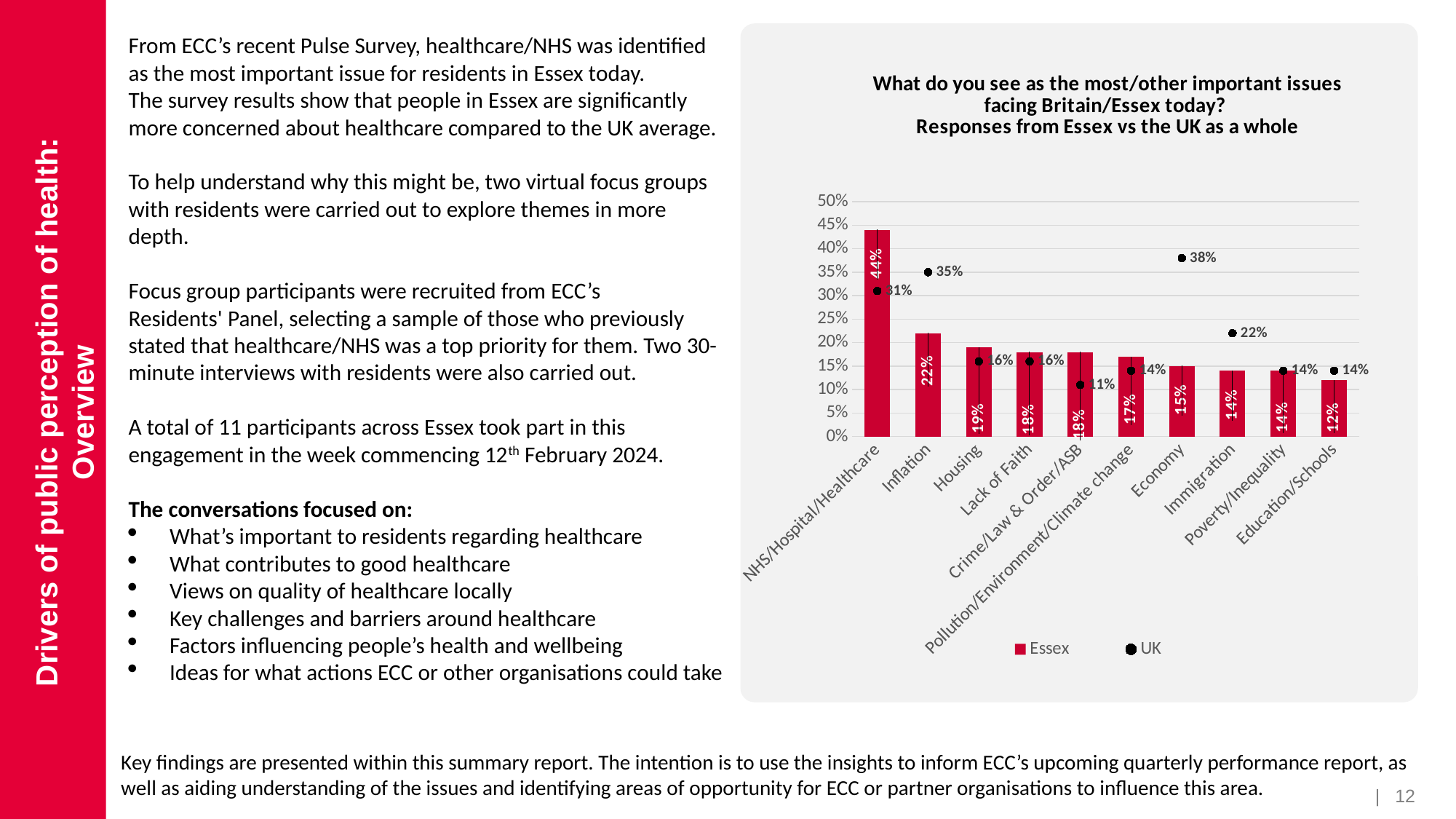
What is the difference between the Essex and UK values for NHS/Hospital/Healthcare? 13 percentage points Which issue has the highest UK value? Economy How many series does the legend list? 2 Which issue has the lowest Essex value? Education/Schools Which issue has the highest Essex value? NHS/Hospital/Healthcare What kind of chart is this? Bar chart What is the Essex value for NHS/Hospital/Healthcare? 44% What is the UK value for Economy? 38% Which issue has the lowest UK value? Crime/Law & Order/ASB What is the UK value for Immigration? 22% For Inflation, which is larger: the Essex value or the UK value? UK How many issue categories are shown on the x axis? 10